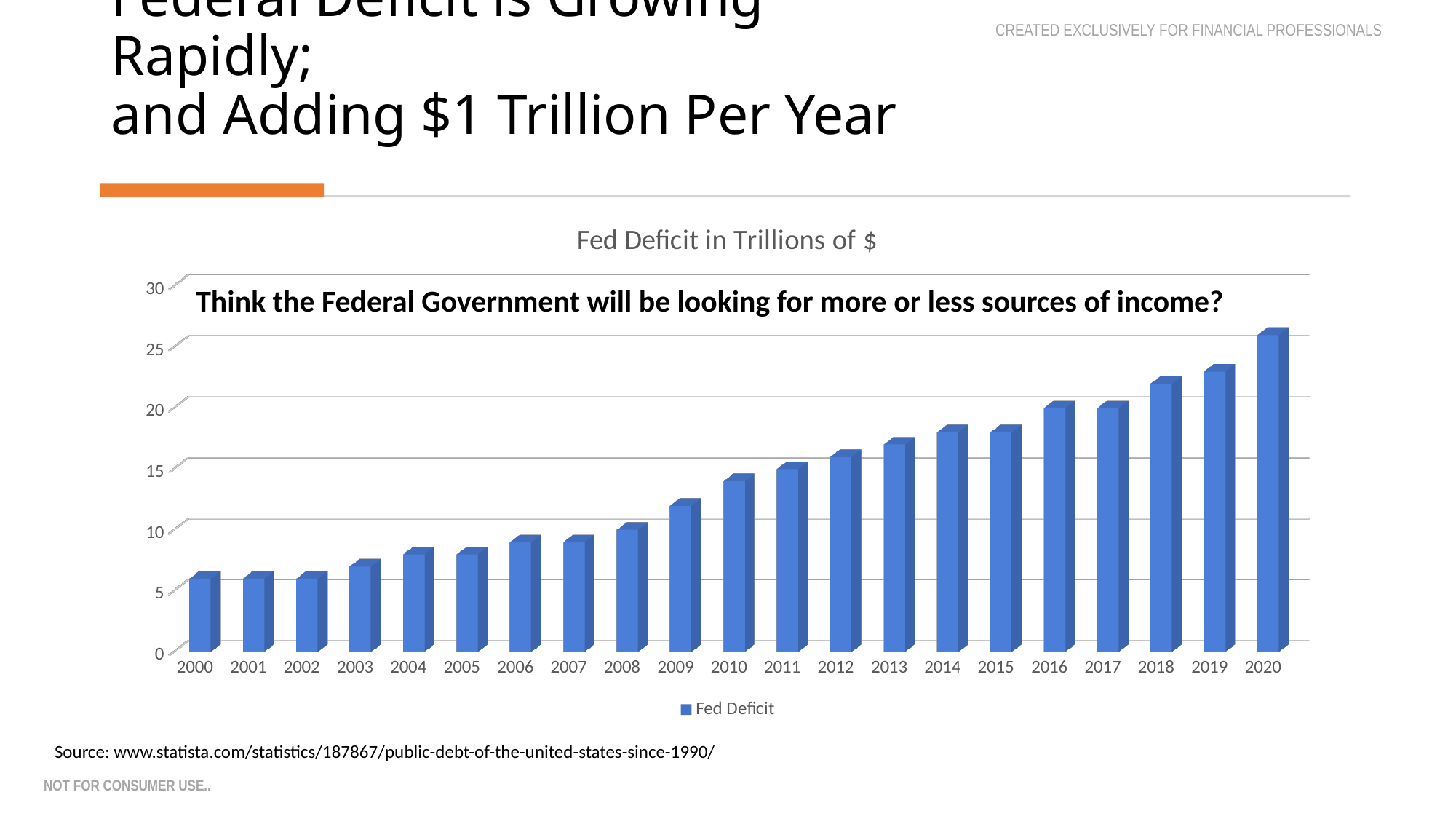
Is the Fed Deficit value for 2020 greater or less than 25? greater How many years are shown along the x axis of the chart? 21 Is the Fed Deficit value for 2018 greater or less than 20? greater Which year has the highest Fed Deficit value? 2020 How many series does the legend list? 1 What kind of chart is shown on the slide? bar chart Is the Fed Deficit value for 2003 greater or less than 10? less Do the Fed Deficit values generally rise or fall from 2000 to 2020? rise Which is larger, the Fed Deficit value for 2012 or for 2006? 2012 What is the title of the chart? Fed Deficit in Trillions of $